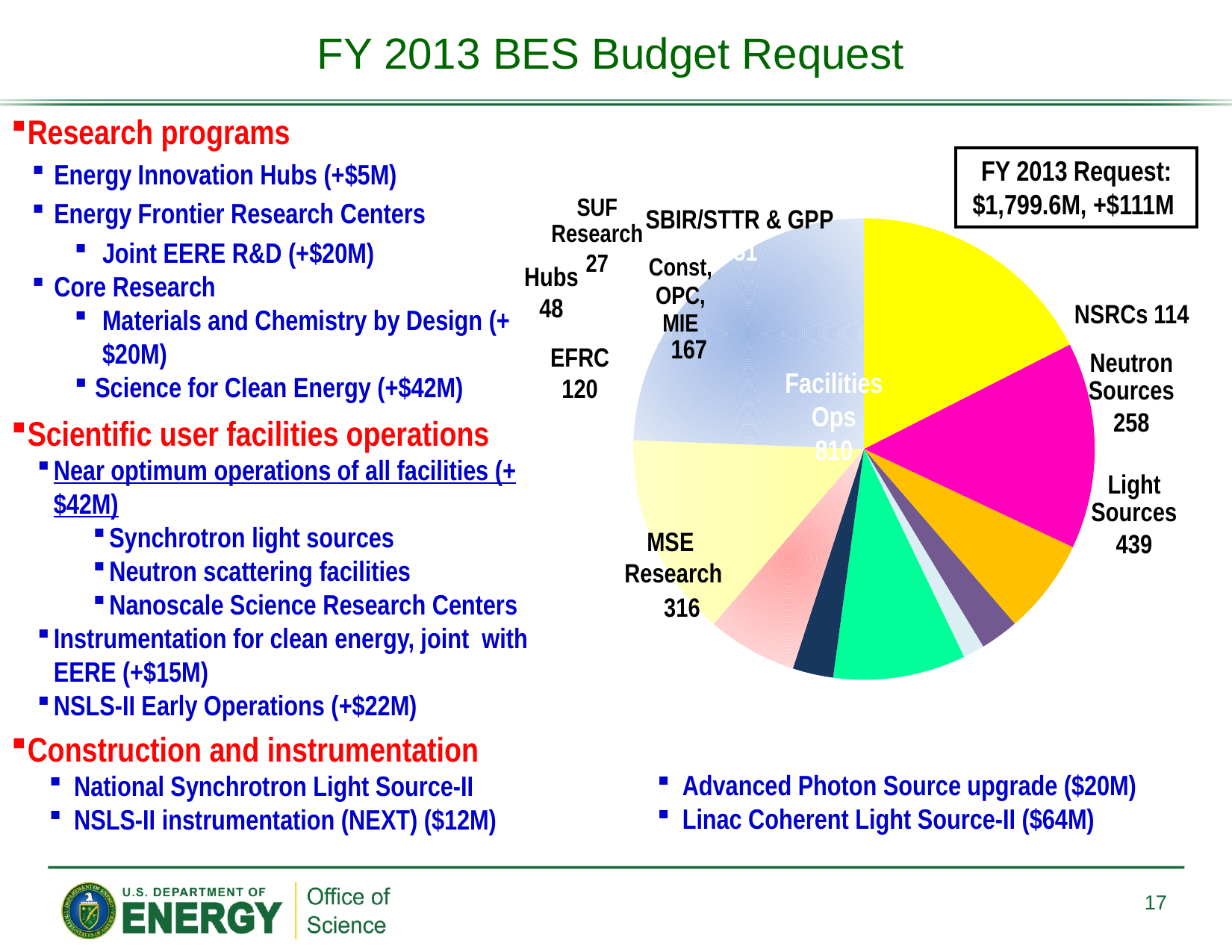
What is the value shown for EFRC in the pie chart? 120 What kind of chart is shown on the slide? pie chart What is the value shown for Hubs in the pie chart? 48 What is the value shown for Neutron Sources in the pie chart? 258 What total FY 2013 request amount is shown in the box next to the pie chart? $1,799.6M, +$111M What is the value shown for Light Sources in the pie chart? 439 What is the difference between the values for Light Sources and Neutron Sources in the pie chart? 181 What is the value shown for Facilities Ops in the pie chart? 810 Which labelled category in the pie chart has the smallest value? SUF Research What is the value shown for NSRCs in the pie chart? 114 What is the value shown for MSE Research in the pie chart? 316 Which labelled category in the pie chart has the largest value? Facilities Ops